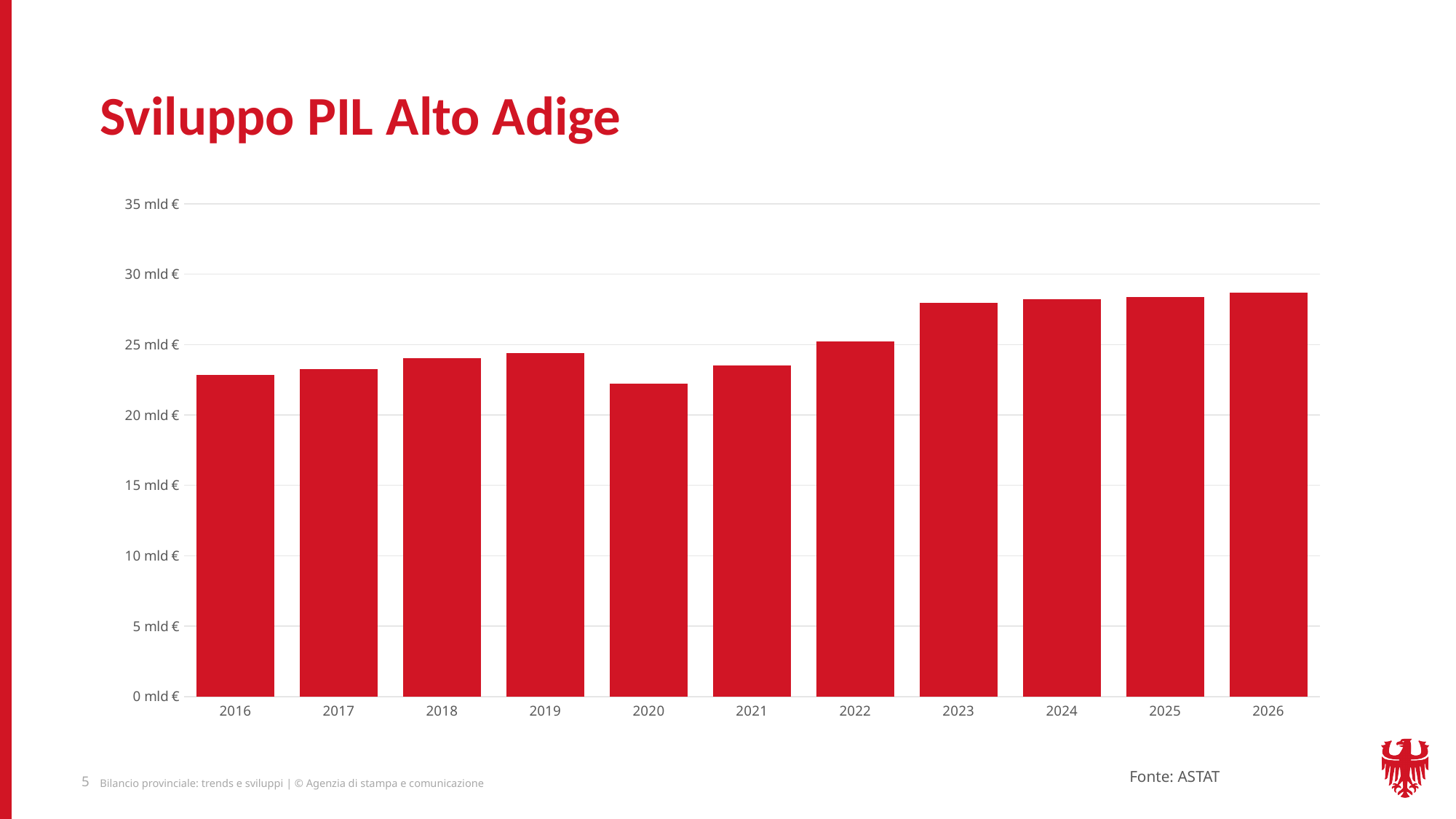
Is the value for 2026 greater or less than 30 mld €? less Is the value for 2023 greater or less than 25 mld €? greater What source is cited for the chart data? ASTAT Is the value for 2020 greater or less than 25 mld €? less What kind of chart is shown on the slide? Bar chart How many years are shown on the x axis of the chart? 11 Which is larger, the value for 2021 or the value for 2020? 2021 What is the title of the chart? Sviluppo PIL Alto Adige Which year has the lowest bar in the chart? 2020 Which is larger, the value for 2023 or the value for 2020? 2023 Do the values generally rise or fall from 2016 to 2026? rise